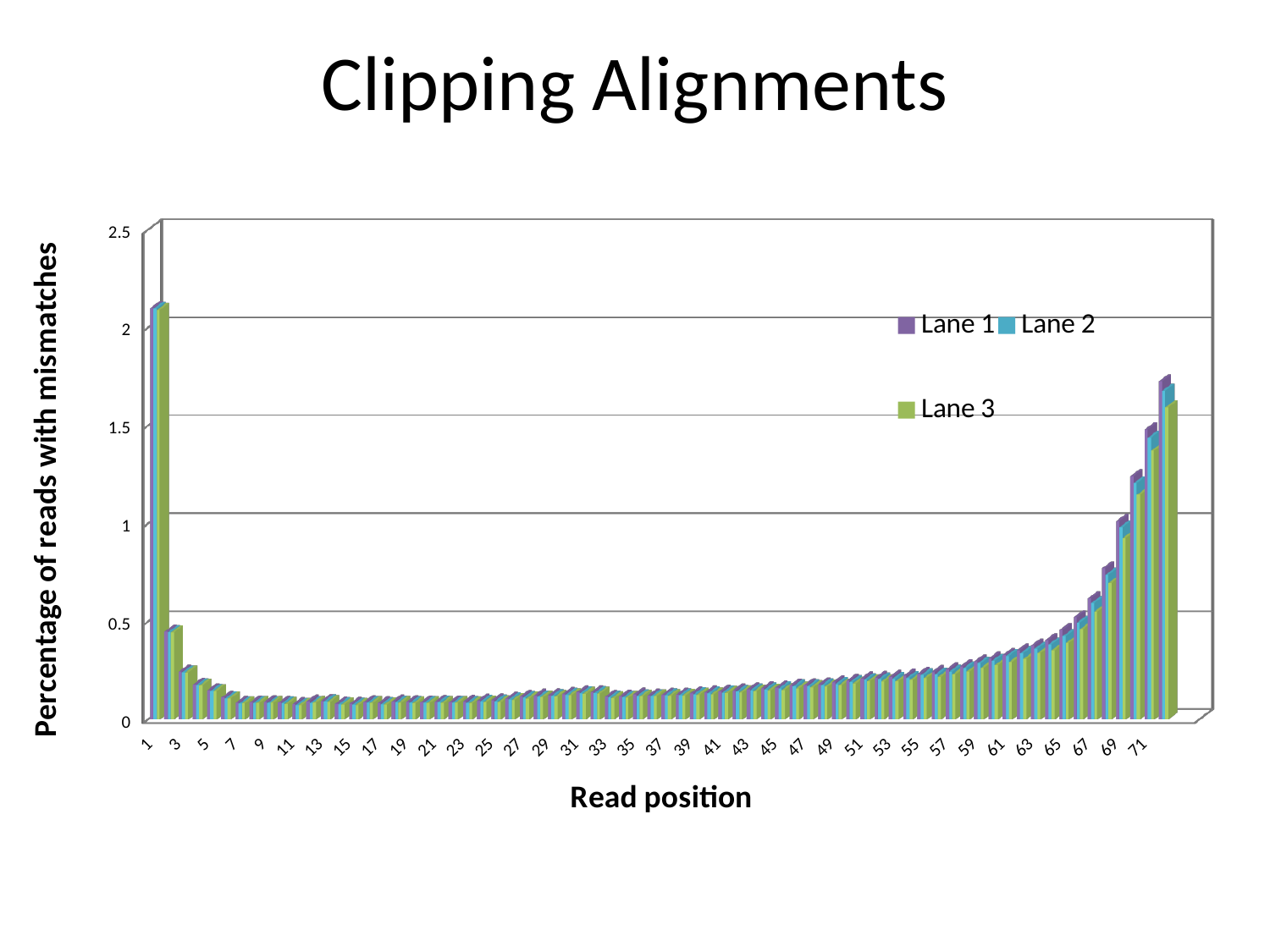
Is the value for Lane 1 at the last read position greater or less than 2? less Is the value for Lane 1 at read position 1 greater or less than 1.5? greater Do the values rise or fall from read position 55 to the last read position? rise Which read position has the highest percentage of reads with mismatches? 1 Is the value for Lane 3 at read position 11 greater or less than 0.5? less Which is larger, the value for Lane 1 at read position 1 or at read position 2? read position 1 What is the title of the y axis? Percentage of reads with mismatches What kind of chart is shown on the slide? bar chart What are the names of the series in the legend? Lane 1, Lane 2, Lane 3 How many series does the legend list? 3